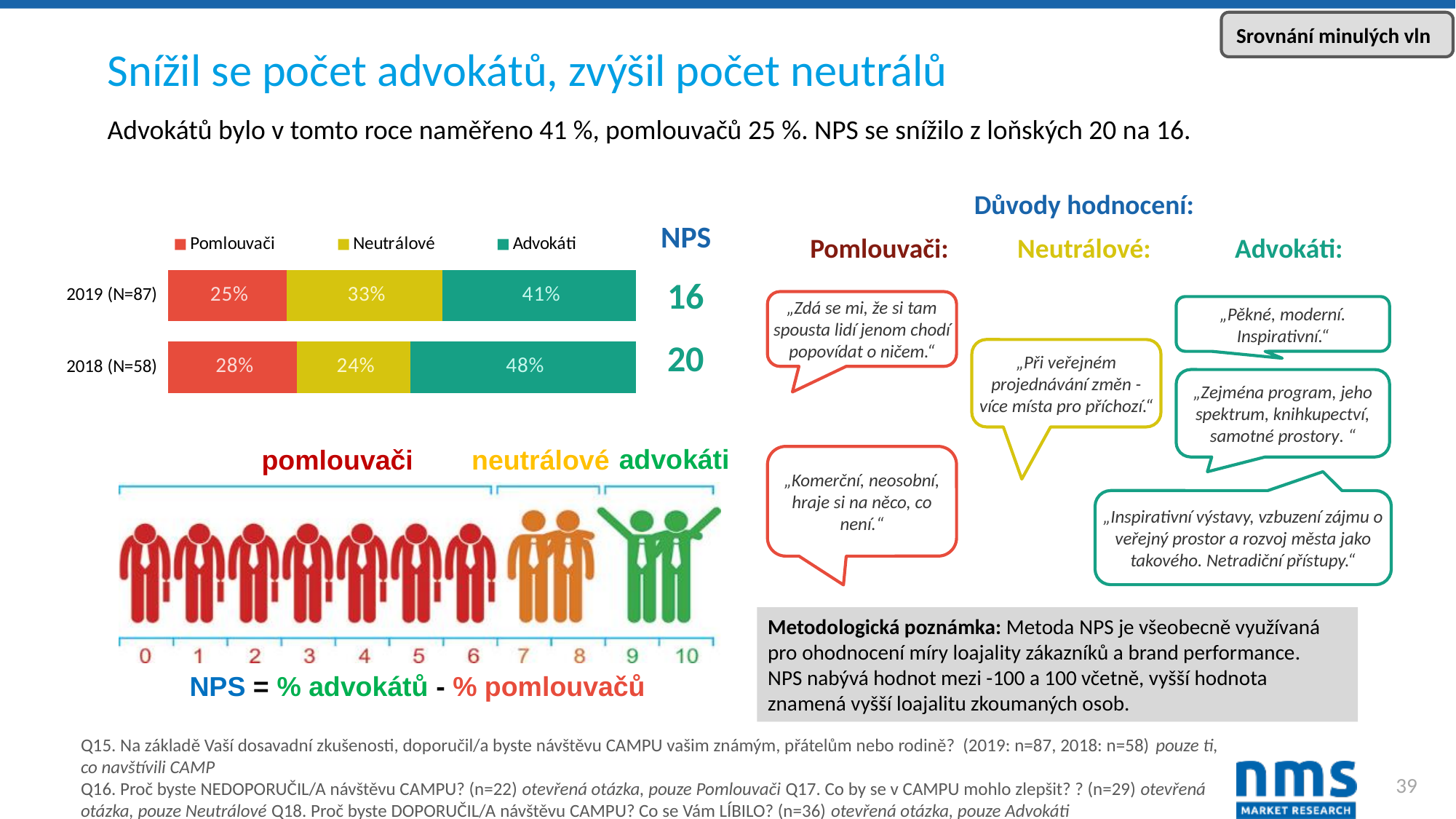
Which segment is the smallest in the 2019 (N=87) bar? Pomlouvači What type of chart is used to show the Pomlouvači, Neutrálové and Advokáti shares? Stacked bar chart What percentage of Pomlouvači is shown for 2019 (N=87)? 25% What is the difference between the Neutrálové shares in 2019 and 2018? 9 percentage points How many series does the chart legend list? 3 What is the NPS value shown next to the 2018 (N=58) bar? 20 What percentage of Advokáti is shown for 2019 (N=87)? 41% Which segment is the largest in the 2018 (N=58) bar? Advokáti By how many percentage points did the share of Advokáti change from 2018 to 2019? 7 percentage points Which year has the higher share of Neutrálové? 2019 (N=87) What percentage of Neutrálové is shown for 2018 (N=58)? 24% How many bars (years) are shown in the chart? 2